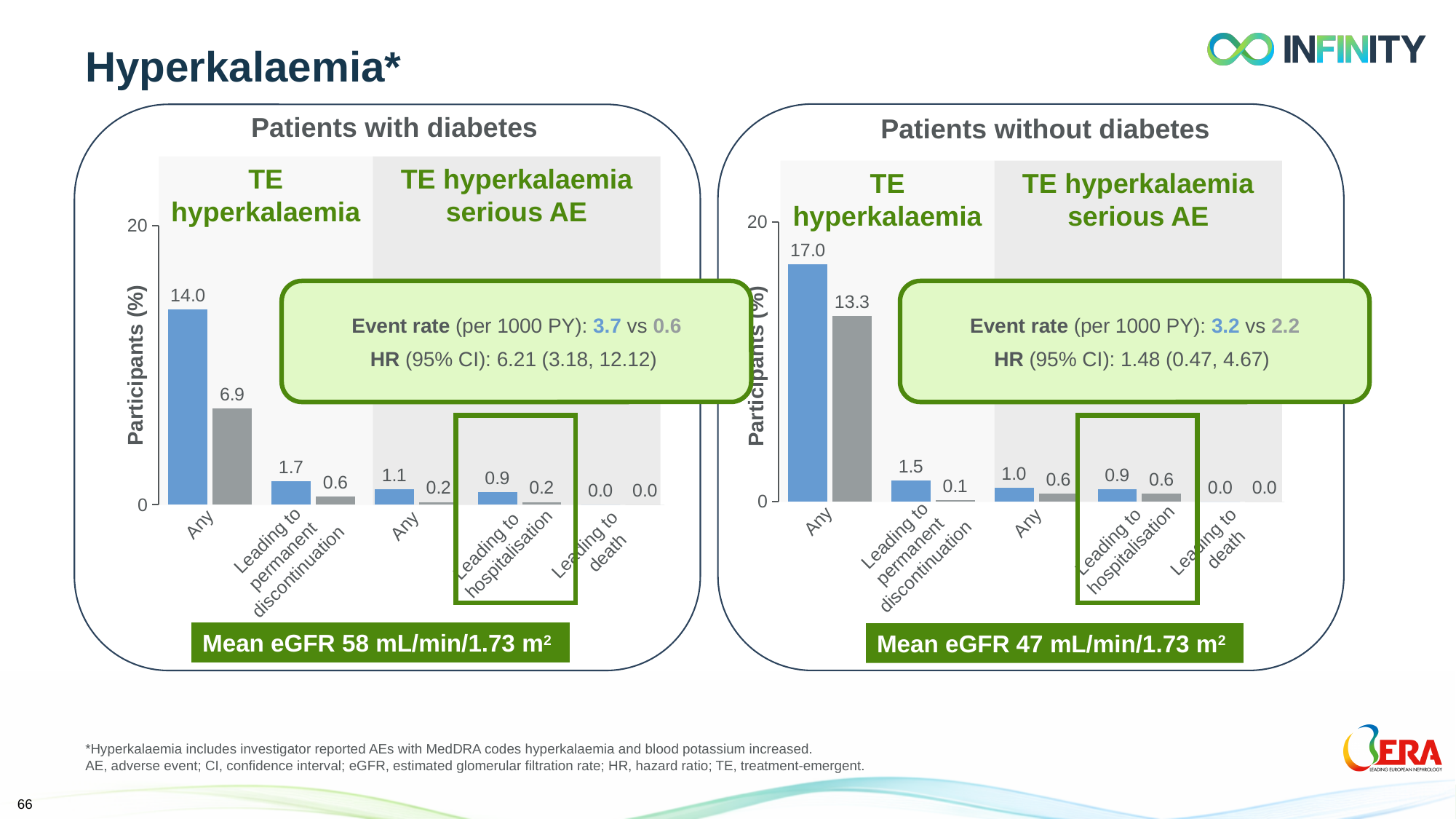
In the 'Patients with diabetes' chart, what is the value of the grey bar for 'Any' TE hyperkalaemia? 6.9 In the 'Patients with diabetes' chart, what is the difference between the blue and grey bars for 'Any' TE hyperkalaemia? 7.1 In the 'Patients without diabetes' chart, is the blue bar for 'Any' TE hyperkalaemia greater or less than 20? less In the 'Patients with diabetes' chart, which category has the highest blue bar? Any (TE hyperkalaemia) What type of chart is used in the 'Patients without diabetes' panel? bar chart In the 'Patients with diabetes' chart, which is larger for 'Leading to hospitalisation': the blue bar or the grey bar? the blue bar In the 'Patients without diabetes' chart, what is the difference between the blue and grey bars for 'Any' TE hyperkalaemia? 3.7 In the 'Patients with diabetes' chart, what is the value of both bars for 'Leading to death'? 0.0 In the 'Patients without diabetes' chart, what is the value of the blue bar for 'Any' TE hyperkalaemia? 17.0 In the 'Patients with diabetes' chart, what is the value of the blue bar for 'Any' TE hyperkalaemia? 14.0 What is the y-axis label of the 'Patients with diabetes' chart? Participants (%) In the 'Patients without diabetes' chart, what is the value of the grey bar for 'Leading to permanent discontinuation'? 0.1